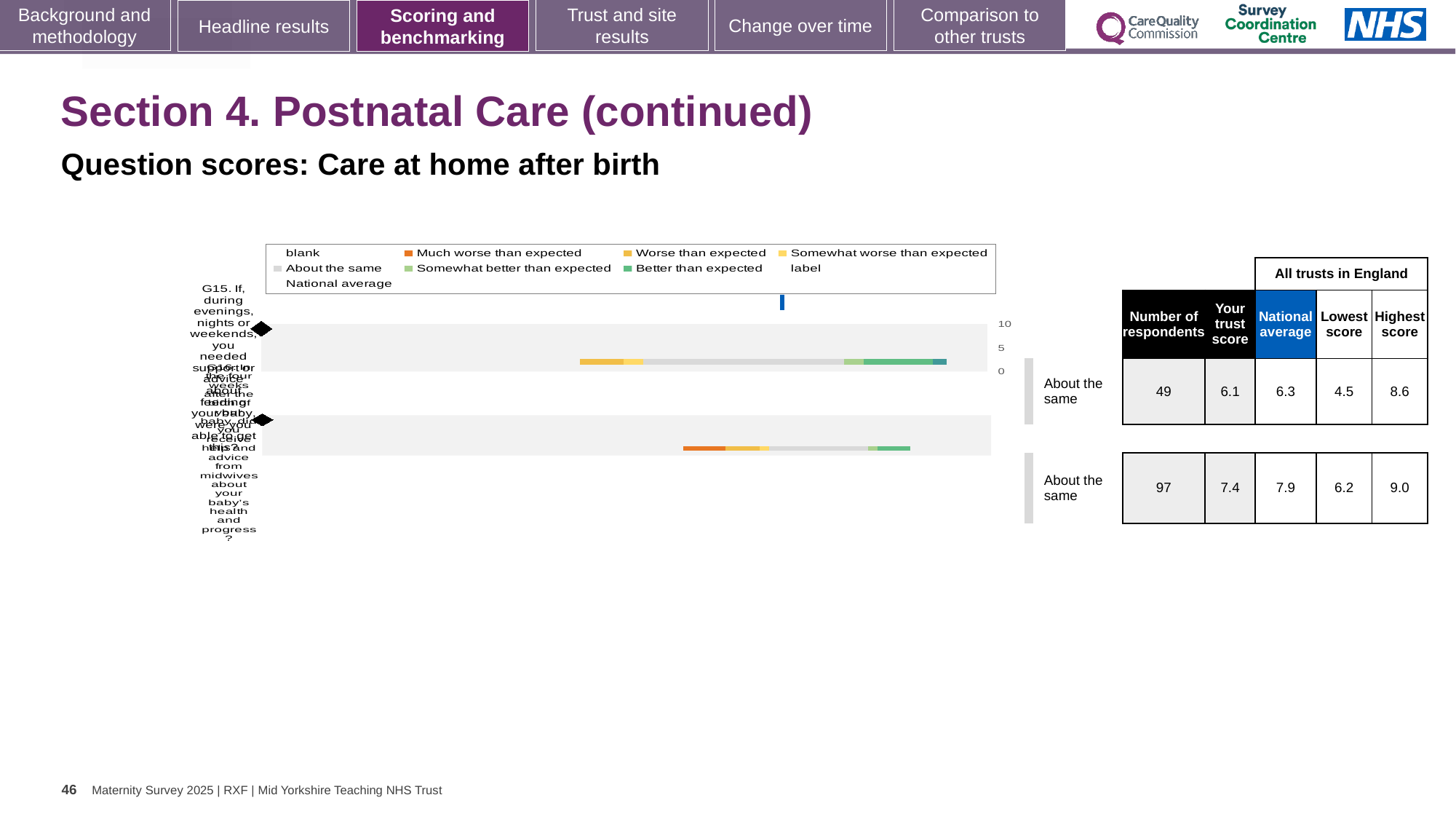
How many entries does the chart legend list? 9 How many respondents are listed for the first question row (G15)? 49 How many question rows (bars) are plotted in the chart? 2 What is the difference between the highest score and the lowest score for the second question row? 2.8 What is the 'Your trust score' for the first question row (G15)? 6.1 What benchmark category is shown for the second question row? About the same What is the difference between the national average and the trust score for the first question row (G15)? 0.2 What kind of chart is shown on the slide? bar chart For the first question row (G15), which is larger: the trust score or the national average? National average What is the highest score across all trusts in England for the first question row (G15)? 8.6 What is the national average for the second question row? 7.9 What is the maximum value shown on the chart's score axis? 10